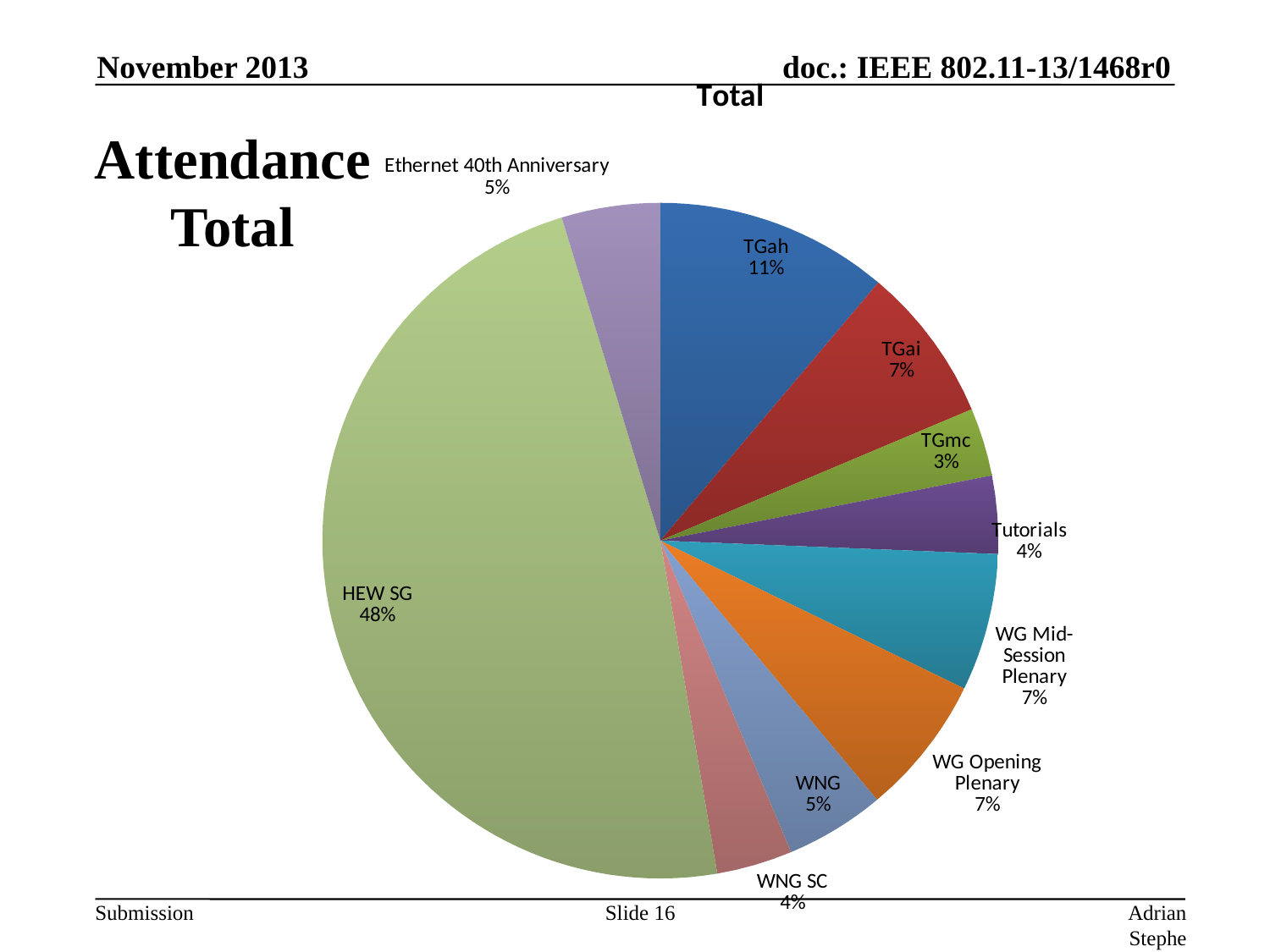
How many slices does the pie chart have? 10 What is the difference in percentage points between TGah and TGai? 4 What percentage is shown for WG Mid-Session Plenary? 7% What percentage is shown for TGah? 11% What is the title of the chart? Total Which category has the largest slice of the pie? HEW SG Which is larger, the share for WNG or the share for WNG SC? WNG What percentage is shown for Ethernet 40th Anniversary? 5% Which category has the smallest slice of the pie? TGmc What kind of chart is shown on the slide? pie chart What share of the pie does HEW SG account for? 48% What percentage is shown for TGmc? 3%